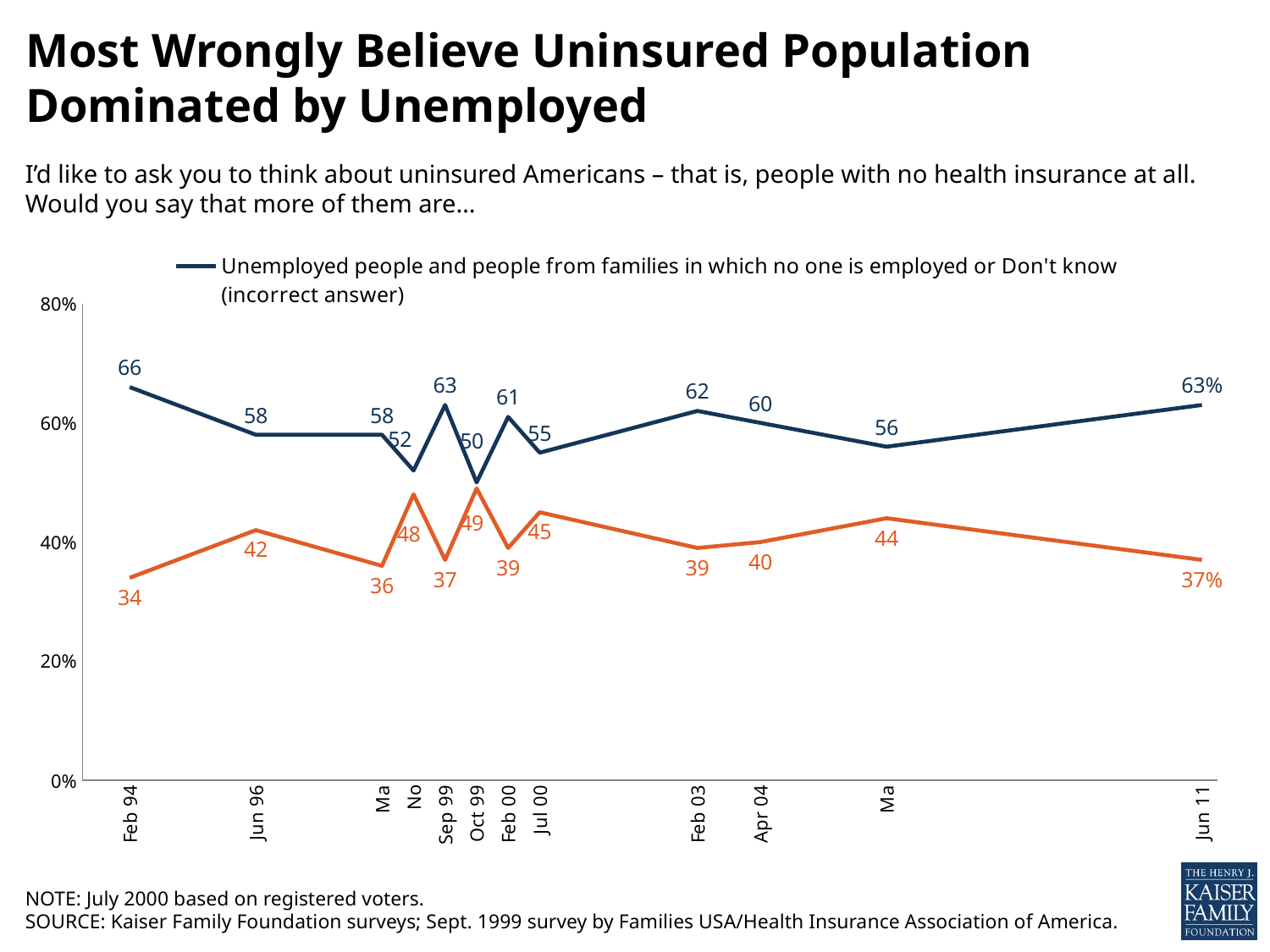
Is the dark blue line (incorrect answer) higher at Feb 03 or at Apr 04? Feb 03 What is the value of the dark blue line (incorrect answer) at Feb 94? 66 At which date does the orange line reach its lowest value? Feb 94 What kind of chart is shown on the slide? line chart What is the difference between the dark blue line and the orange line at Jun 11? 26 What is the value of the dark blue line (incorrect answer) at Jun 11? 63% At which date does the dark blue line (incorrect answer) reach its highest value? Feb 94 What is the difference between the dark blue line and the orange line at Feb 94? 32 At which date does the dark blue line (incorrect answer) reach its lowest value? Oct 99 How many series does the legend list? 1 What is the value of the orange line at Feb 94? 34 What is the value of the orange line at Jun 11? 37%